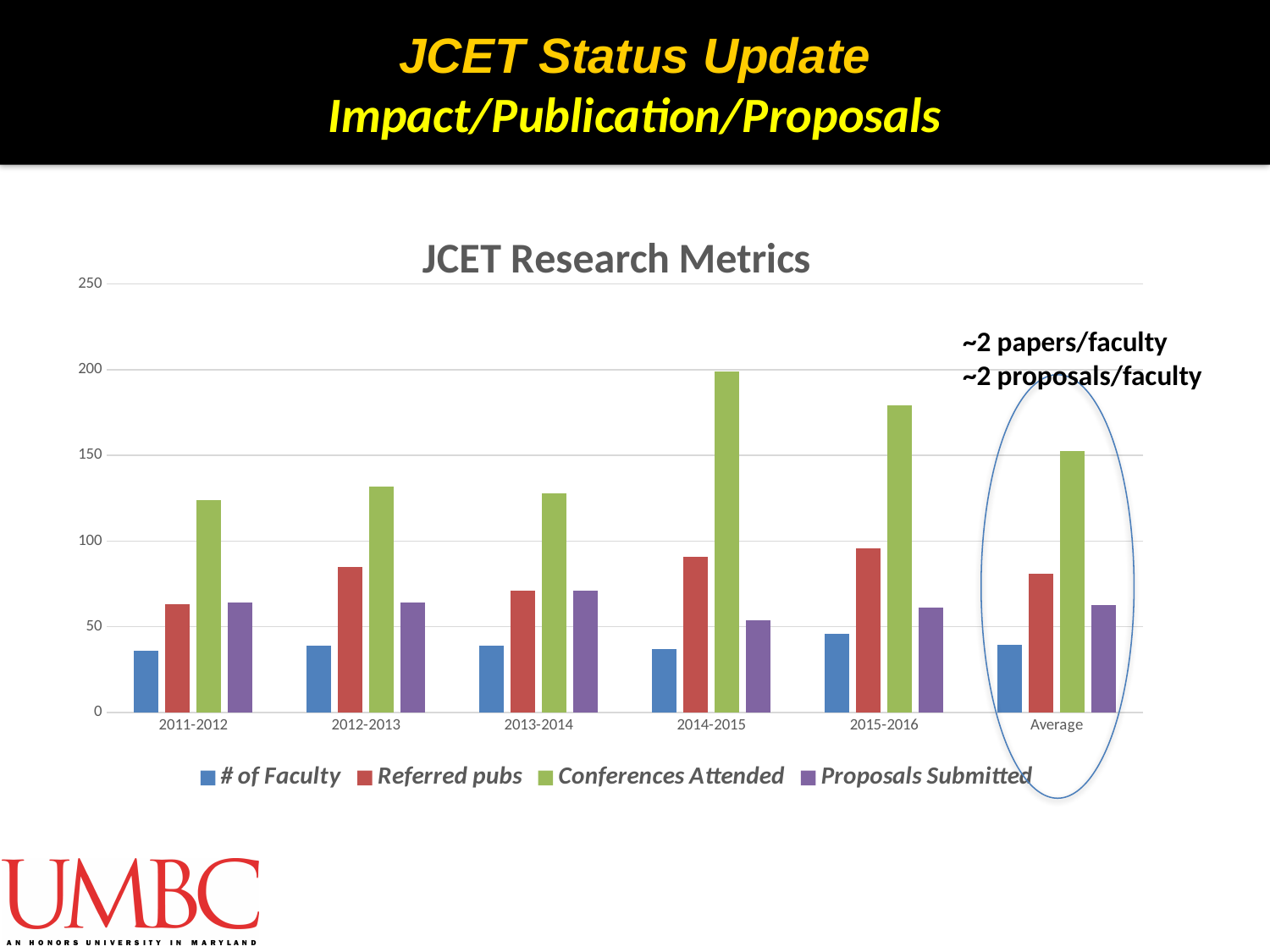
Is the value for Referred pubs in 2012-2013 greater or less than 100? less Which year has the lowest value for Proposals Submitted? 2014-2015 Which is larger: Referred pubs in 2015-2016 or Referred pubs in 2011-2012? 2015-2016 What is the title of the chart? JCET Research Metrics How many series does the legend of the JCET Research Metrics chart list? 4 Which category on the x axis is circled on the slide? Average What type of chart is shown on the slide? Bar chart Which category has the highest value for Conferences Attended? 2014-2015 In 2013-2014, which is larger: Conferences Attended or Proposals Submitted? Conferences Attended Is the value for Conferences Attended in 2014-2015 greater or less than 150? greater How many categories are shown along the x axis of the JCET Research Metrics chart? 6 Is the value for # of Faculty in 2015-2016 greater or less than 50? less